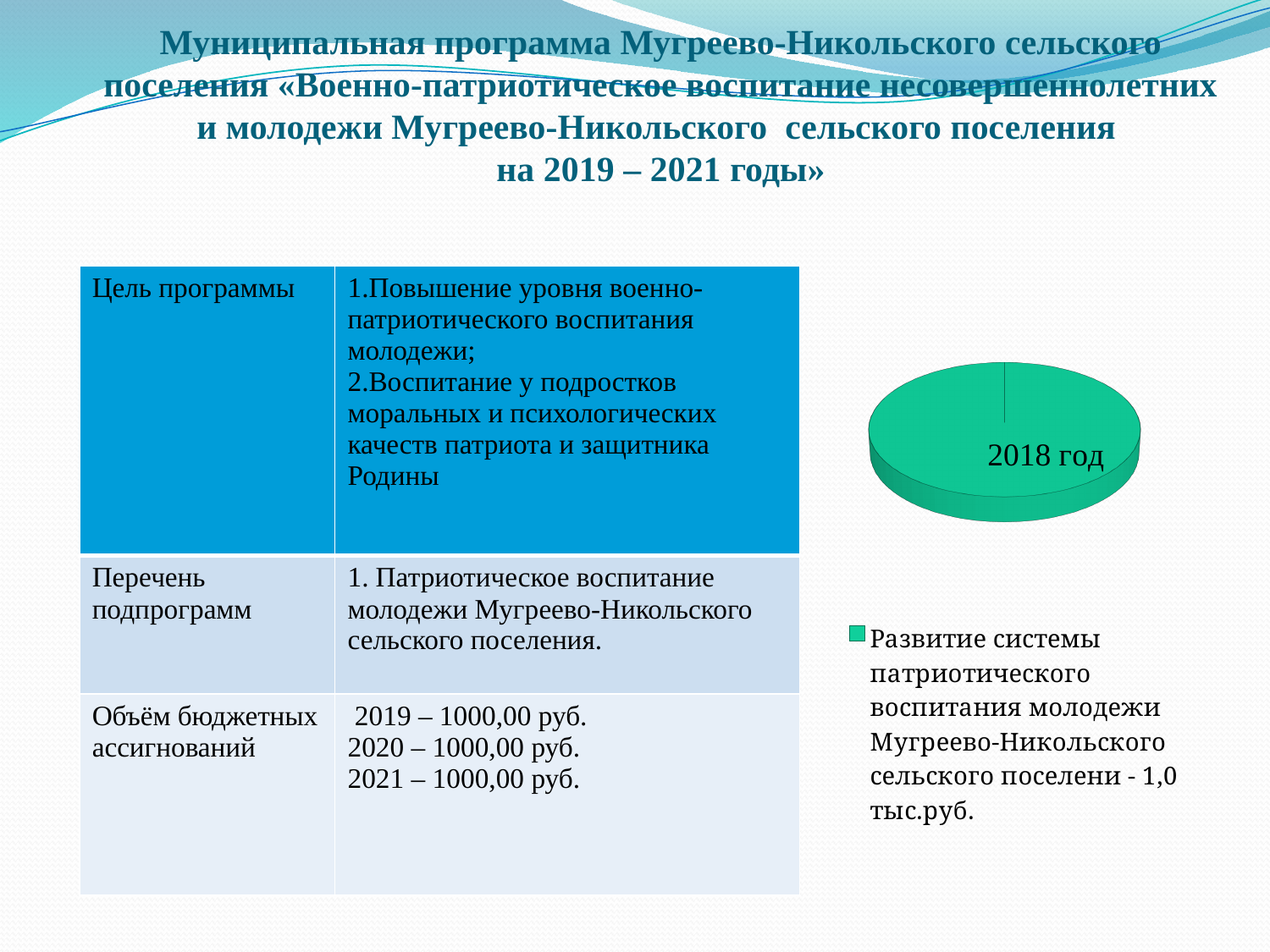
What value is printed in the legend for "Развитие системы патриотического воспитания молодежи Мугреево-Никольского сельского поселени"? 1,0 тыс.руб. What kind of chart is shown on the right side of the slide? pie chart How many slices does the pie chart contain? 1 What year is written on the pie chart? 2018 год How many entries does the legend of the pie chart list? 1 What colour is the single slice of the pie chart? green What share of the pie does the slice "Развитие системы патриотического воспитания молодежи Мугреево-Никольского сельского поселени" take up? 100%